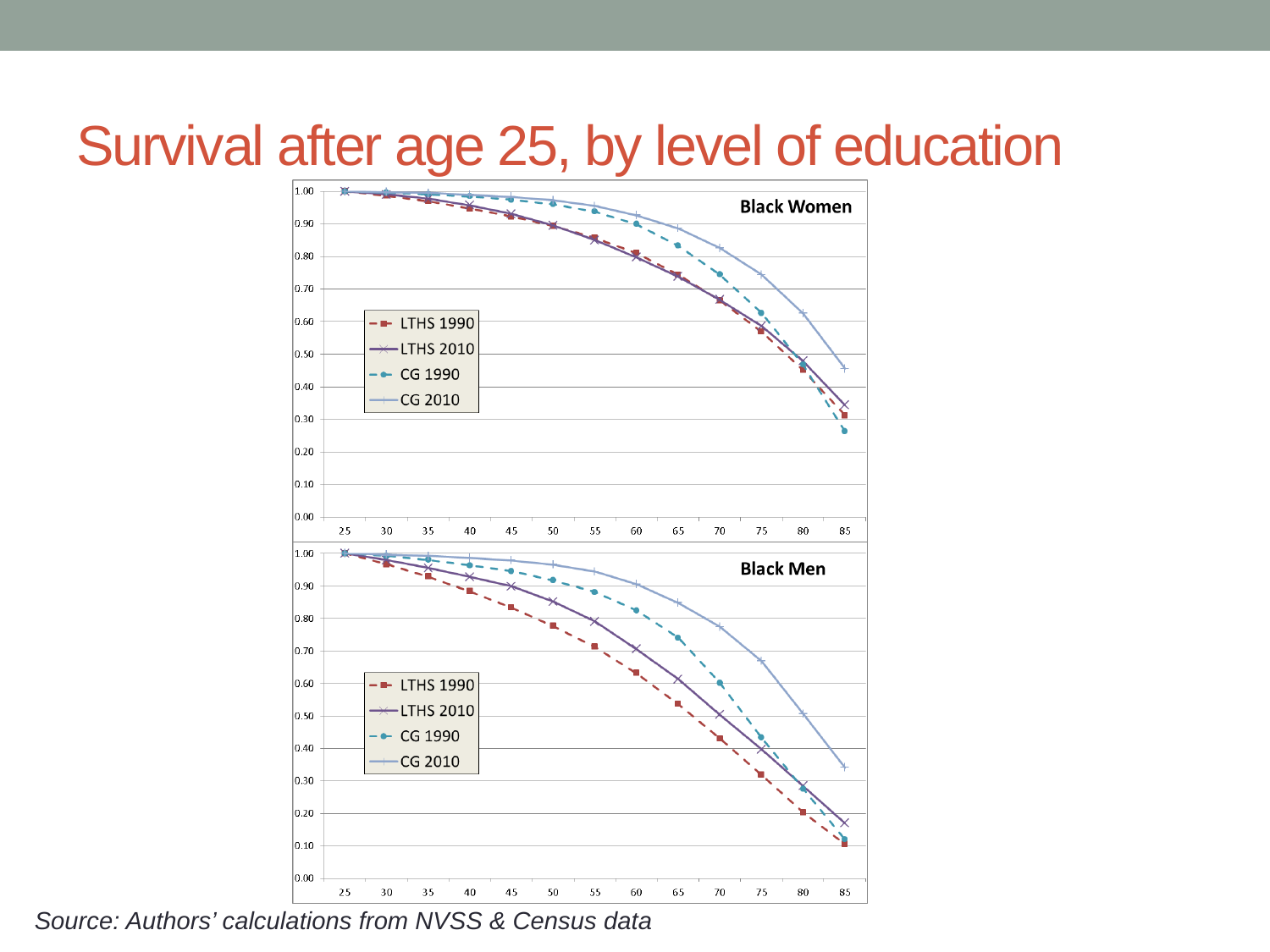
How many series does the legend of the Black Men chart list? 4 In the Black Men chart, do the survival values rise or fall as age increases? fall In the Black Women chart, is the value for LTHS 2010 at age 55 greater or less than 0.80? greater What kind of chart is the Black Women chart? line chart In the Black Men chart, is the value for LTHS 1990 at age 85 greater or less than 0.20? less In the Black Men chart, which series has the lowest value at age 60? LTHS 1990 In the Black Women chart, is the value for CG 2010 at age 85 greater or less than 0.40? greater How many age points are plotted along the x axis of the Black Women chart? 13 In the Black Women chart, which is larger at age 75: CG 2010 or LTHS 1990? CG 2010 In the Black Men chart, which is larger at age 85: CG 2010 or LTHS 1990? CG 2010 In the Black Men chart, which series has the highest value at age 65? CG 2010